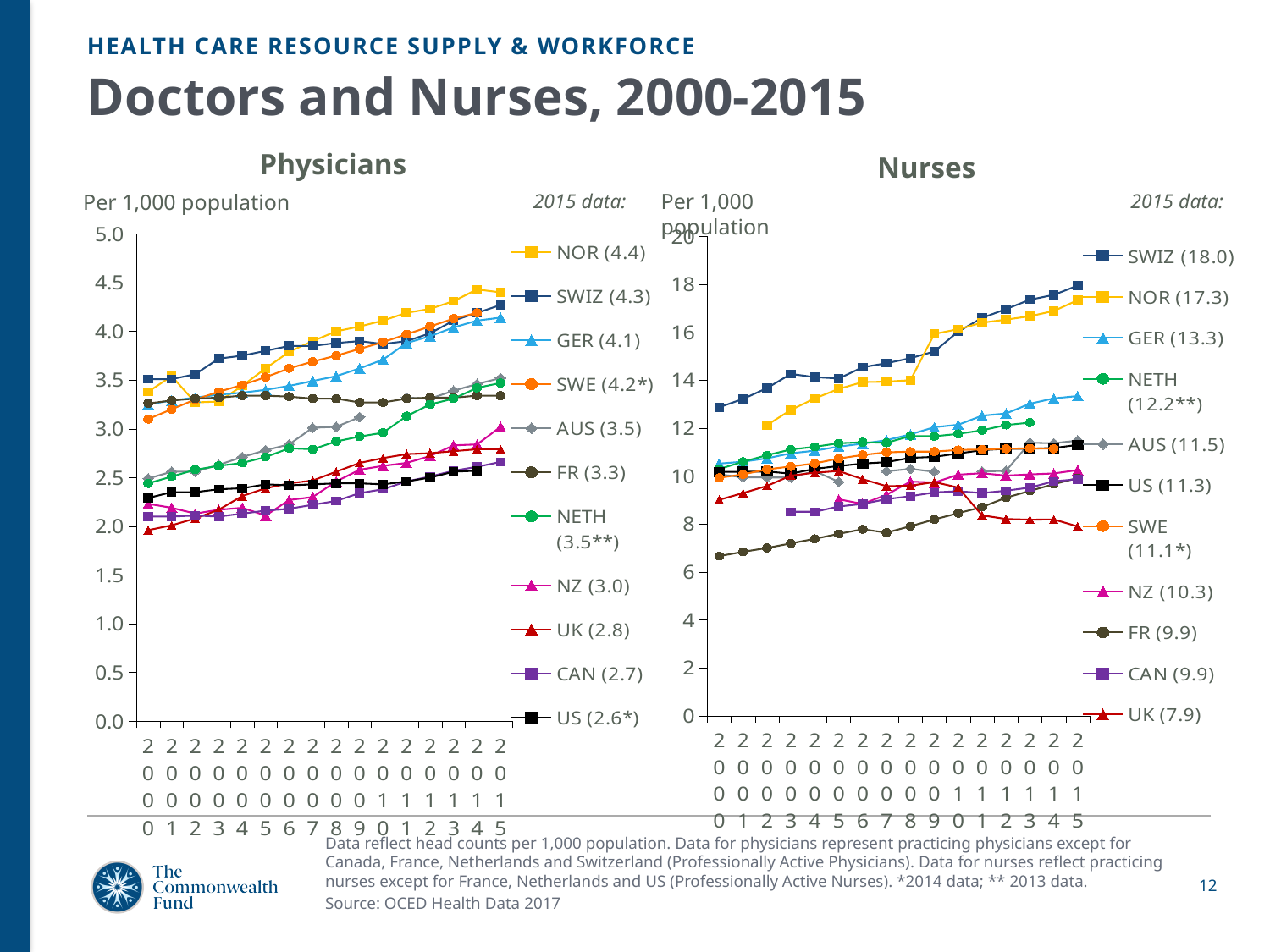
On the Nurses chart, which has the larger 2015 value, GER or NETH? GER On the Nurses chart, what is the difference between the 2015 values for SWIZ and NOR? 0.7 How many years are shown on the x axis of the Physicians chart? 16 On the Nurses chart, what is the 2015 value for SWIZ? 18.0 On the Physicians chart, what is the 2015 value for NOR? 4.4 How many series does the legend of the Physicians chart list? 11 On the Nurses chart, does the SWIZ line rise or fall from 2000 to 2015? Rise On the Physicians chart, what is the difference between the 2015 values for NOR and US? 1.8 What kind of chart is the Nurses chart? Line chart On the Physicians chart, is the value for FR in 2000 greater or less than 3.0? greater On the Nurses chart, which country has the lowest 2015 value? UK On the Physicians chart, which country has the highest 2015 value? NOR